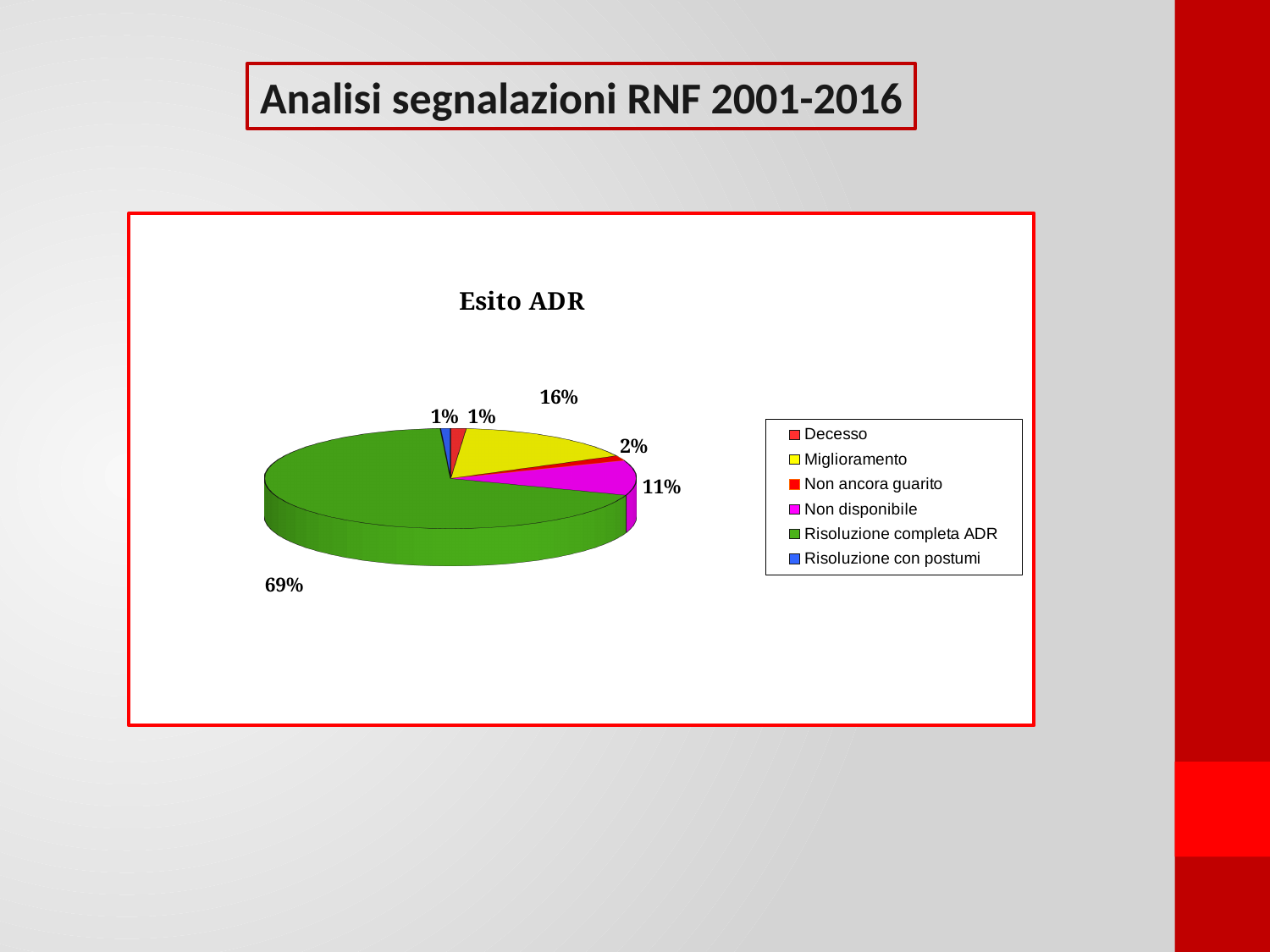
What kind of chart is shown on the slide? pie chart Which category has the largest slice of the pie? Risoluzione completa ADR What share of the pie does Non ancora guarito represent? 2% What share of the pie does Non disponibile represent? 11% Which is larger, the share for Miglioramento or the share for Non disponibile? Miglioramento What share of the pie does Decesso represent? 1% What colour is the slice for Risoluzione completa ADR? green How many categories does the legend list? 6 What is the difference between the share for Risoluzione completa ADR and the share for Miglioramento? 53% What is the title of the chart? Esito ADR